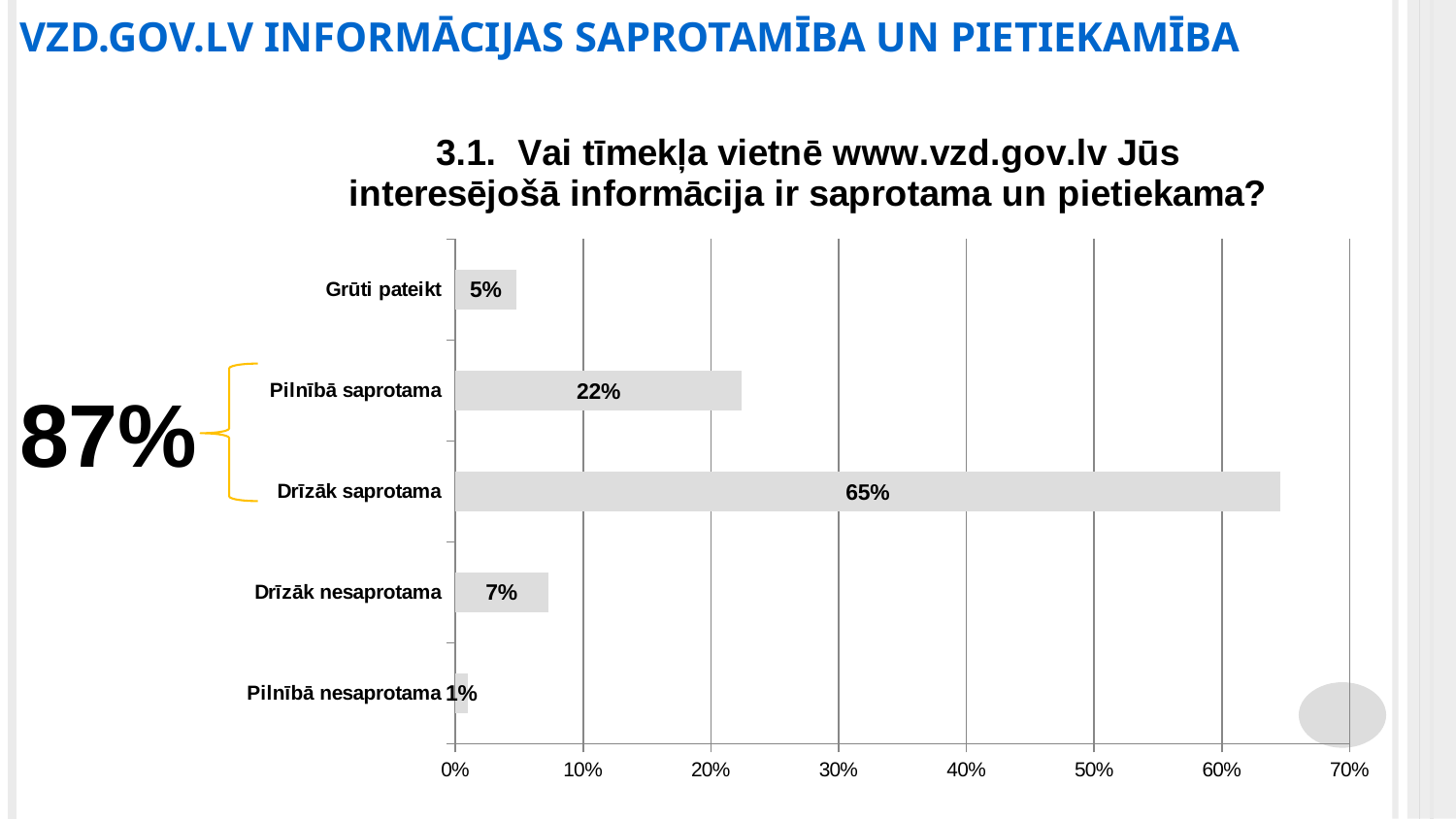
What percentage is shown next to the bracket grouping "Pilnībā saprotama" and "Drīzāk saprotama"? 87% What is the value for "Grūti pateikt"? 5% Is the value for "Drīzāk saprotama" greater or less than 60%? greater What is the value for "Pilnībā saprotama"? 22% What is the value for "Drīzāk saprotama"? 65% What is the difference between the values for "Drīzāk saprotama" and "Pilnībā saprotama"? 43% Which category has the lowest value? Pilnībā nesaprotama What kind of chart is shown on the slide? bar chart Which category has the highest value? Drīzāk saprotama Which is larger, the value for "Drīzāk nesaprotama" or the value for "Grūti pateikt"? Drīzāk nesaprotama What is the value for "Pilnībā nesaprotama"? 1% How many categories are shown in the chart? 5